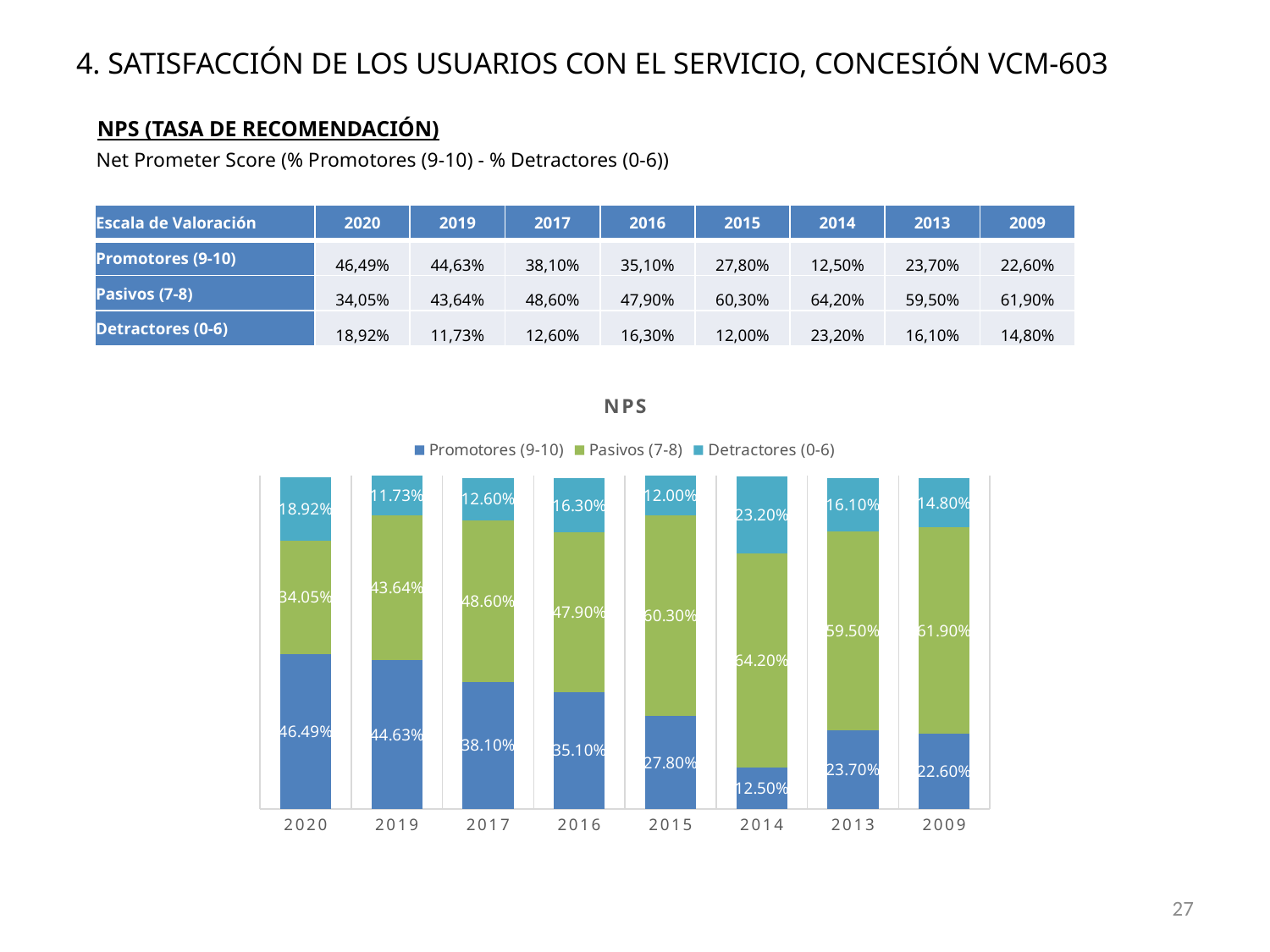
What is the difference between the Promotores (9-10) values for 2020 and 2019 in the NPS chart? 1.86% How many series does the legend of the NPS chart list? 3 What is the value for Promotores (9-10) in 2020 in the NPS chart? 46.49% Which is larger in the NPS chart: Pasivos (7-8) in 2015 or Pasivos (7-8) in 2013? Pasivos (7-8) in 2015 Which series is shown in green in the NPS chart? Pasivos (7-8) What kind of chart is the NPS chart? Stacked bar chart In which year is the Promotores (9-10) value lowest in the NPS chart? 2014 How many years are shown on the x axis of the NPS chart? 8 In which year is the Promotores (9-10) value highest in the NPS chart? 2020 What is the value for Detractores (0-6) in 2019 in the NPS chart? 11.73% In which year is the Detractores (0-6) value highest in the NPS chart? 2014 What is the value for Pasivos (7-8) in 2014 in the NPS chart? 64.20%